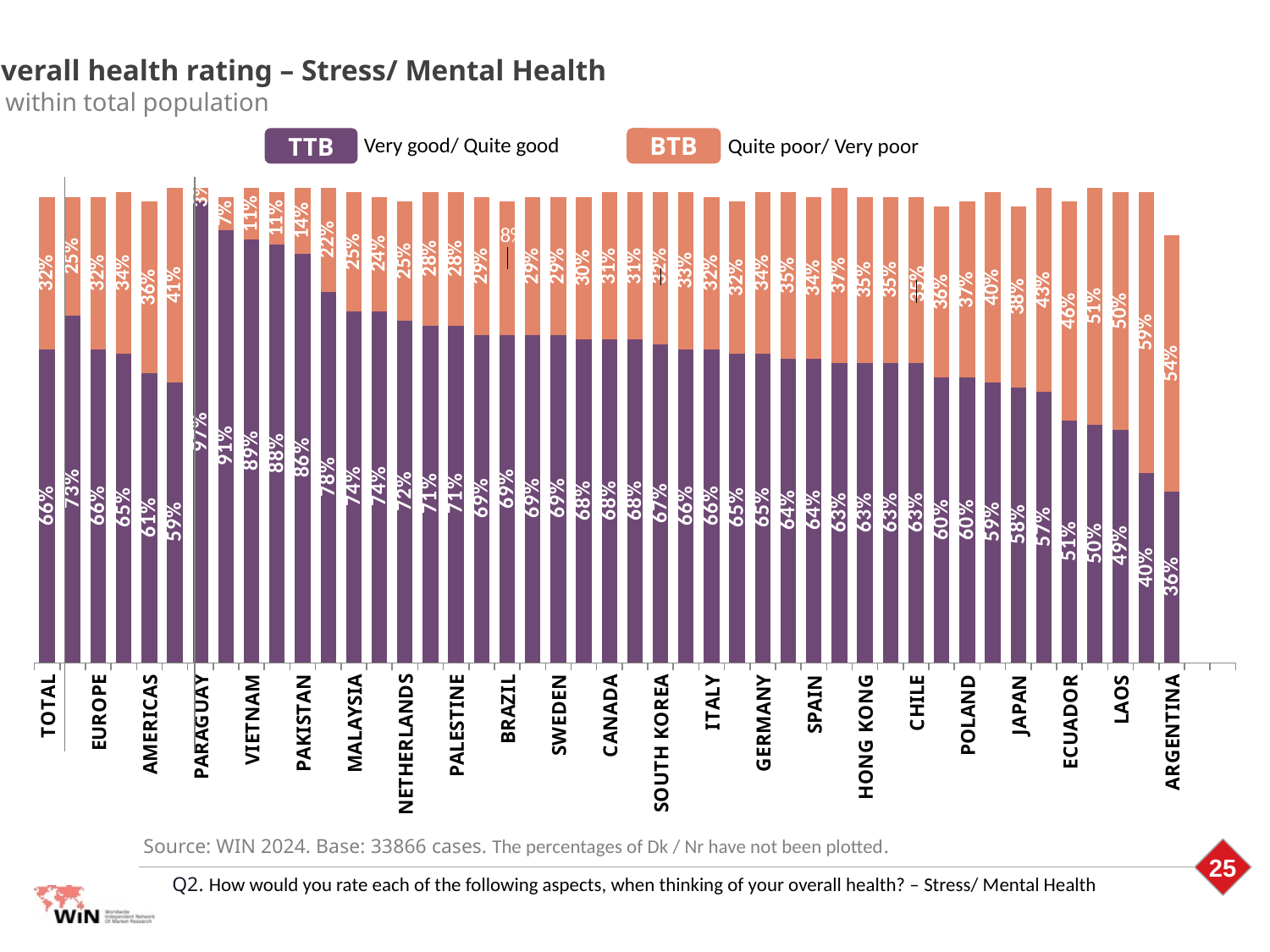
Which labelled country has the highest TTB (Very good/ Quite good) value? Paraguay What kind of chart is shown on the slide? Stacked bar chart Which has a higher TTB value, Malaysia or Laos? Malaysia How many series does the legend list? 2 What is the BTB (Quite poor/ Very poor) value for Argentina? 54% What is the TTB (Very good/ Quite good) value for Paraguay? 97% What is the TTB value for Vietnam? 89% What is the difference between the TTB values for Pakistan and Japan? 28% What is the BTB value for Ecuador? 46% Which labelled country has the lowest TTB (Very good/ Quite good) value? Argentina Which labelled country has the lowest BTB (Quite poor/ Very poor) value? Paraguay According to the legend, what does TTB stand for? Very good/ Quite good